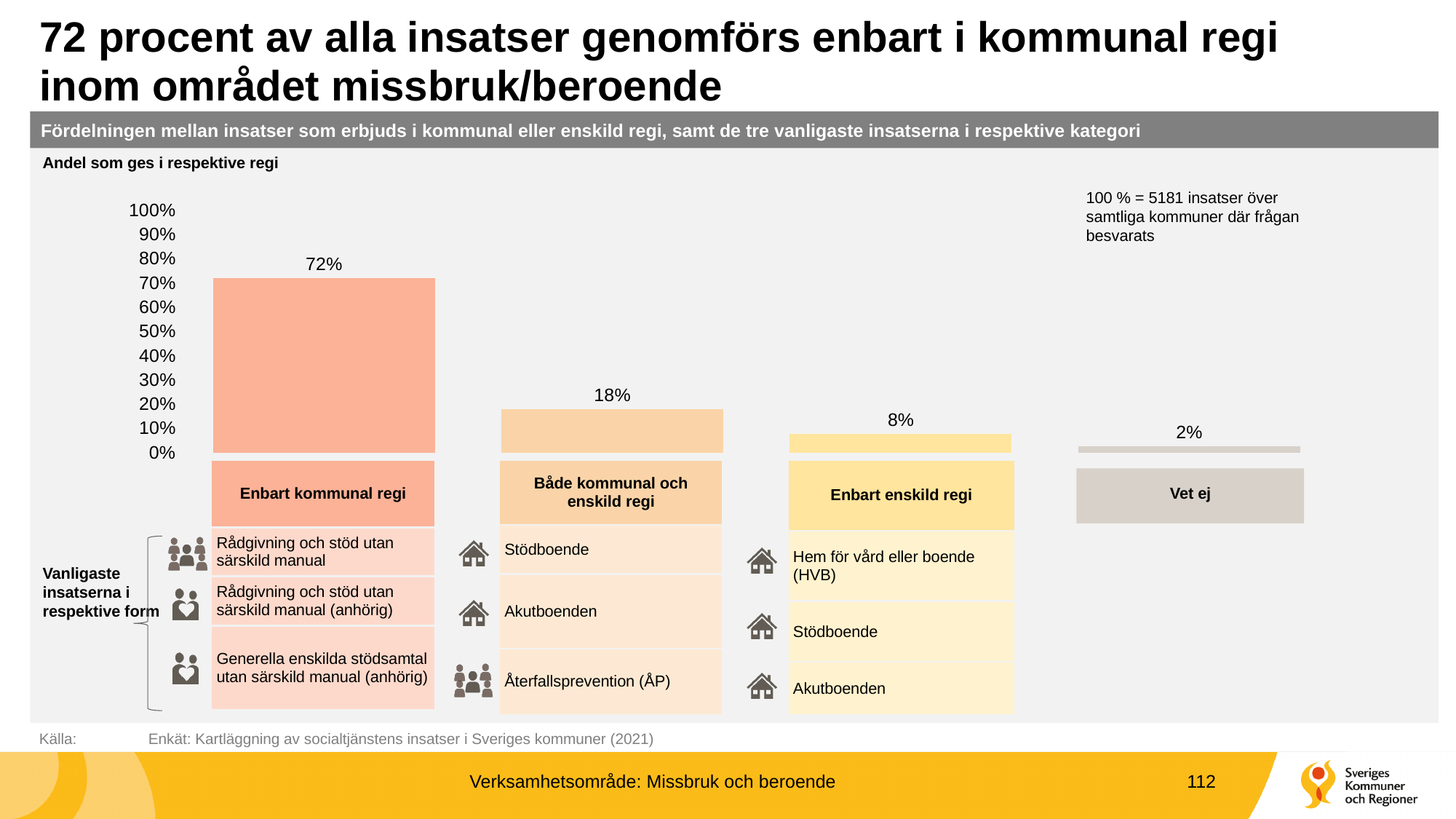
Do the values rise or fall from left to right across the categories? Fall What kind of chart is shown on the slide? Bar chart What is the total of the values for Enbart enskild regi and Vet ej? 10% Which category has the highest value? Enbart kommunal regi How many categories are shown in the bar chart? 4 Which is larger, the value for Enbart enskild regi or the value for Vet ej? Enbart enskild regi What is the difference between the values for Enbart kommunal regi and Både kommunal och enskild regi? 54 percentage points What is the value for Både kommunal och enskild regi? 18% What is the value for Vet ej? 2% Which category has the lowest value? Vet ej What is the value for Enbart enskild regi? 8% What is the value for Enbart kommunal regi? 72%